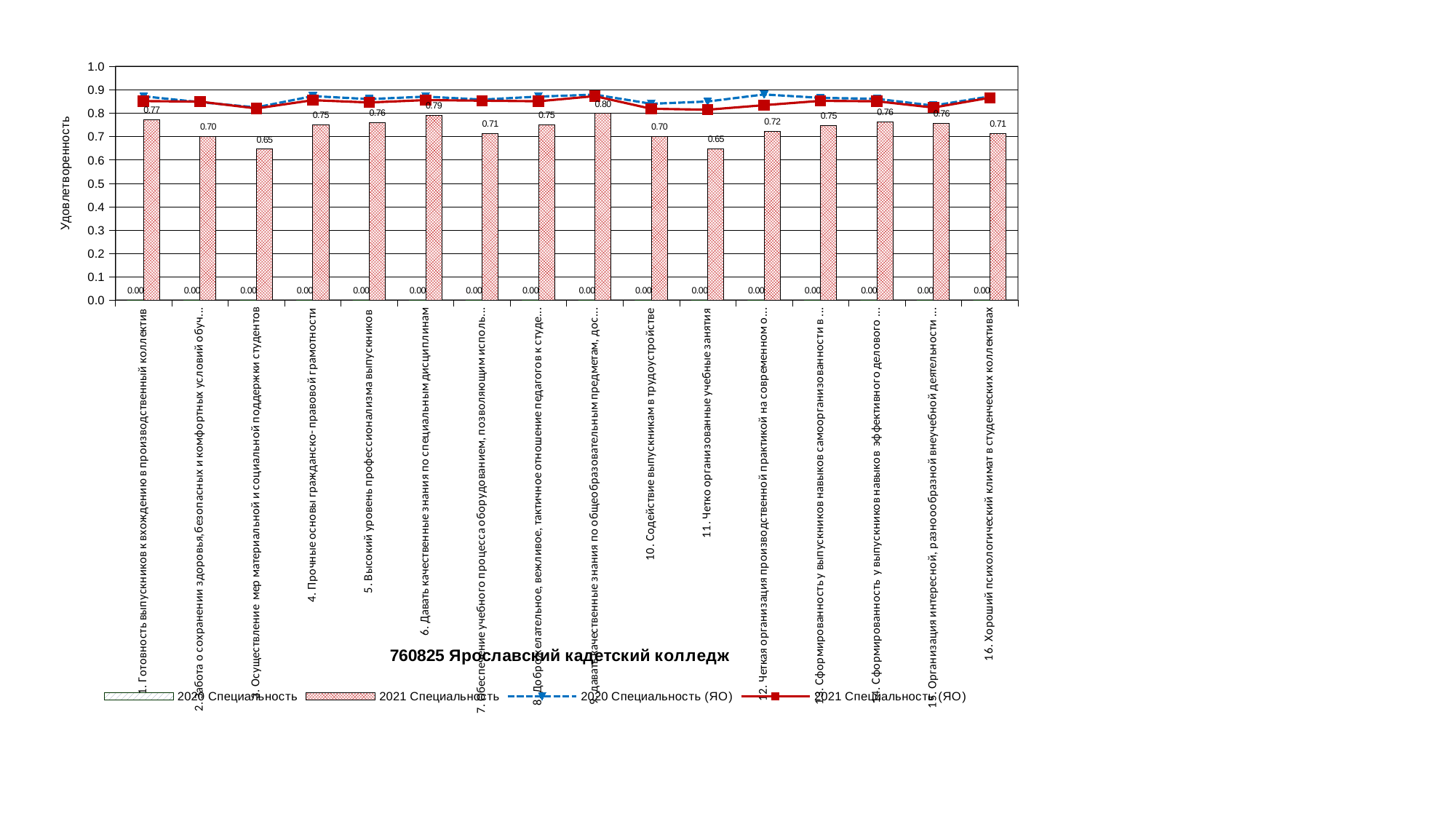
What is the title of the chart? 760825 Ярославский кадетский колледж What is the difference between the 2021 Специальность values for category 1 (Готовность выпускников к вхождению в производственный коллектив) and category 16 (Хороший психологический климат в студенческих коллективах)? 0.06 What is the 2021 Специальность value for "16. Хороший психологический климат в студенческих коллективах"? 0.71 Which category has the highest 2021 Специальность value? Category 9 (0.80) What is the 2020 Специальность value for "10. Содействие выпускникам в трудоустройстве"? 0.00 How many series does the legend list? 4 What is the 2021 Специальность value for "5. Высокий уровень профессионализма выпускников"? 0.76 What is the 2021 Специальность value for "1. Готовность выпускников к вхождению в производственный коллектив"? 0.77 Which has the larger 2021 Специальность value: "5. Высокий уровень профессионализма выпускников" or "10. Содействие выпускникам в трудоустройстве"? 5. Высокий уровень профессионализма выпускников Is the 2021 Специальность (ЯО) value for "11. Четко организованные учебные занятия" greater or less than 0.9? less How many categories are shown on the x axis? 16 What is the 2021 Специальность value for "11. Четко организованные учебные занятия"? 0.65